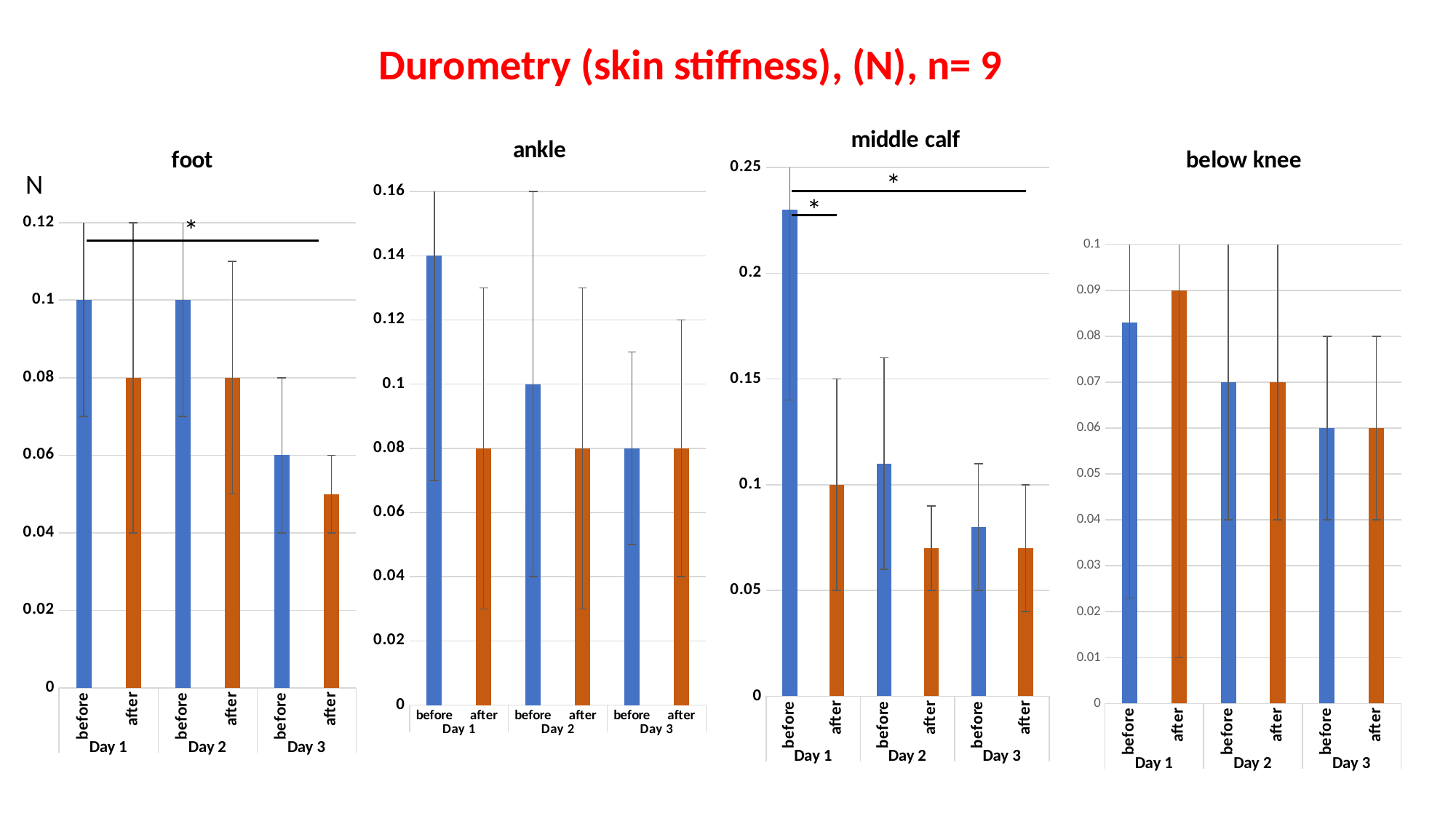
In the 'middle calf' chart, do the 'before' values rise or fall from Day 1 to Day 3? fall In the 'middle calf' chart, what is the value for 'after' on Day 1? 0.1 How many charts are shown on the slide? 4 In the 'foot' chart, what is the value for 'before' on Day 3? 0.06 In the 'below knee' chart, what is the value for 'after' on Day 1? 0.09 In the 'ankle' chart, what is the value for 'before' on Day 1? 0.14 What kind of chart is used for the 'foot' panel? bar chart In the 'ankle' chart, what is the difference between 'before' and 'after' on Day 1? 0.06 In the 'foot' chart, what is the value for 'before' on Day 1? 0.1 In the 'middle calf' chart, is the value for 'before' on Day 1 greater or less than 0.2? greater In the 'middle calf' chart, which bar is the highest? Day 1 before In the 'foot' chart, which is larger on Day 1, 'before' or 'after'? before